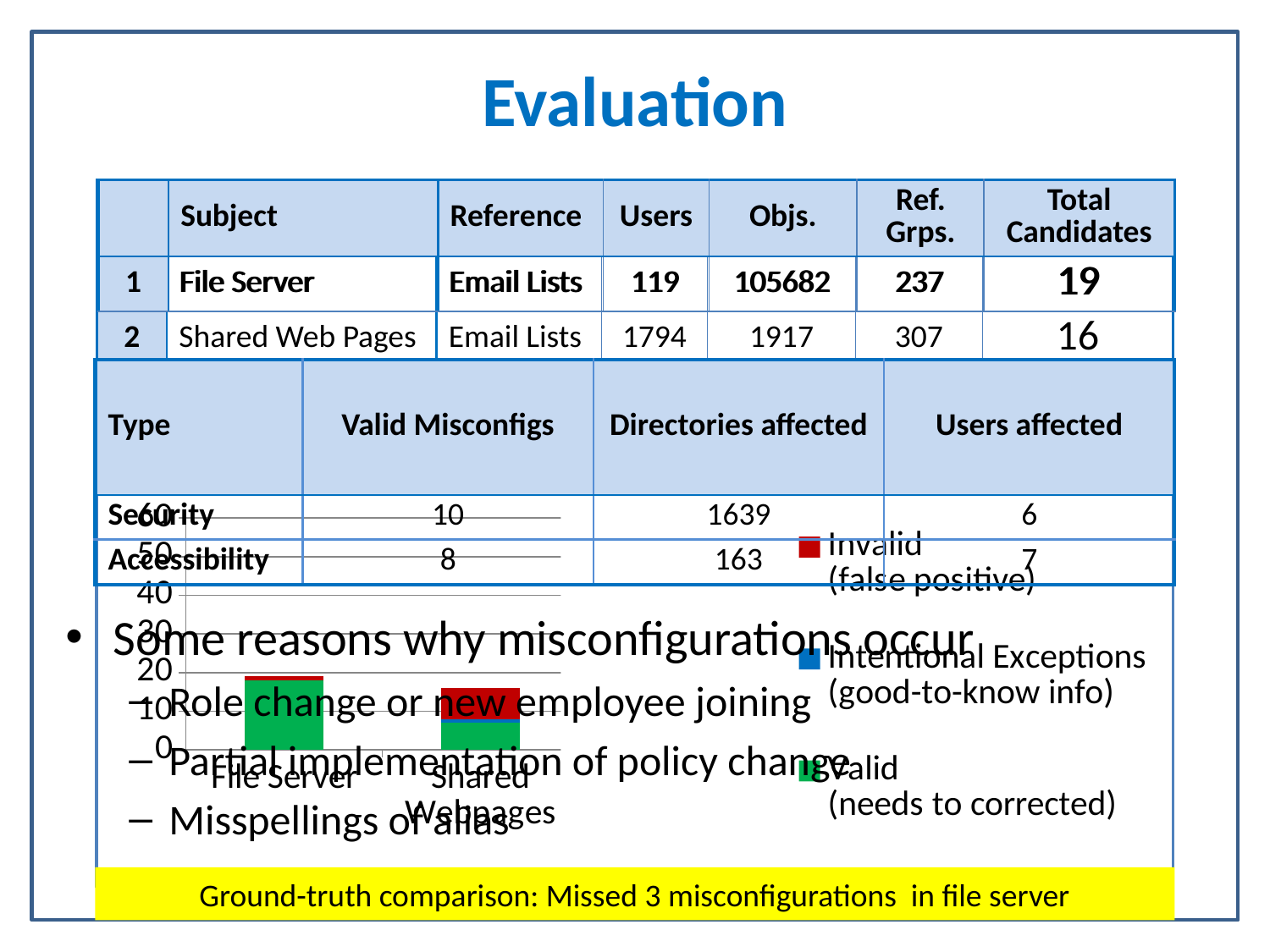
How many series does the chart legend list? 3 What kind of chart is shown on the slide? stacked bar chart Which category has the larger Valid (needs to corrected) segment, File Server or Shared Webpages? File Server Is the total bar height for File Server greater or less than 40? less Which colour represents the Invalid (false positive) series in the chart? red Which category has the taller bar in the chart, File Server or Shared Webpages? File Server Is the total bar height for File Server greater or less than 10? greater Is the total bar height for Shared Webpages greater or less than 30? less Which category has the larger Invalid (false positive) segment, File Server or Shared Webpages? Shared Webpages What is the highest value shown on the chart's y axis? 60 How many categories are shown on the x axis of the chart? 2